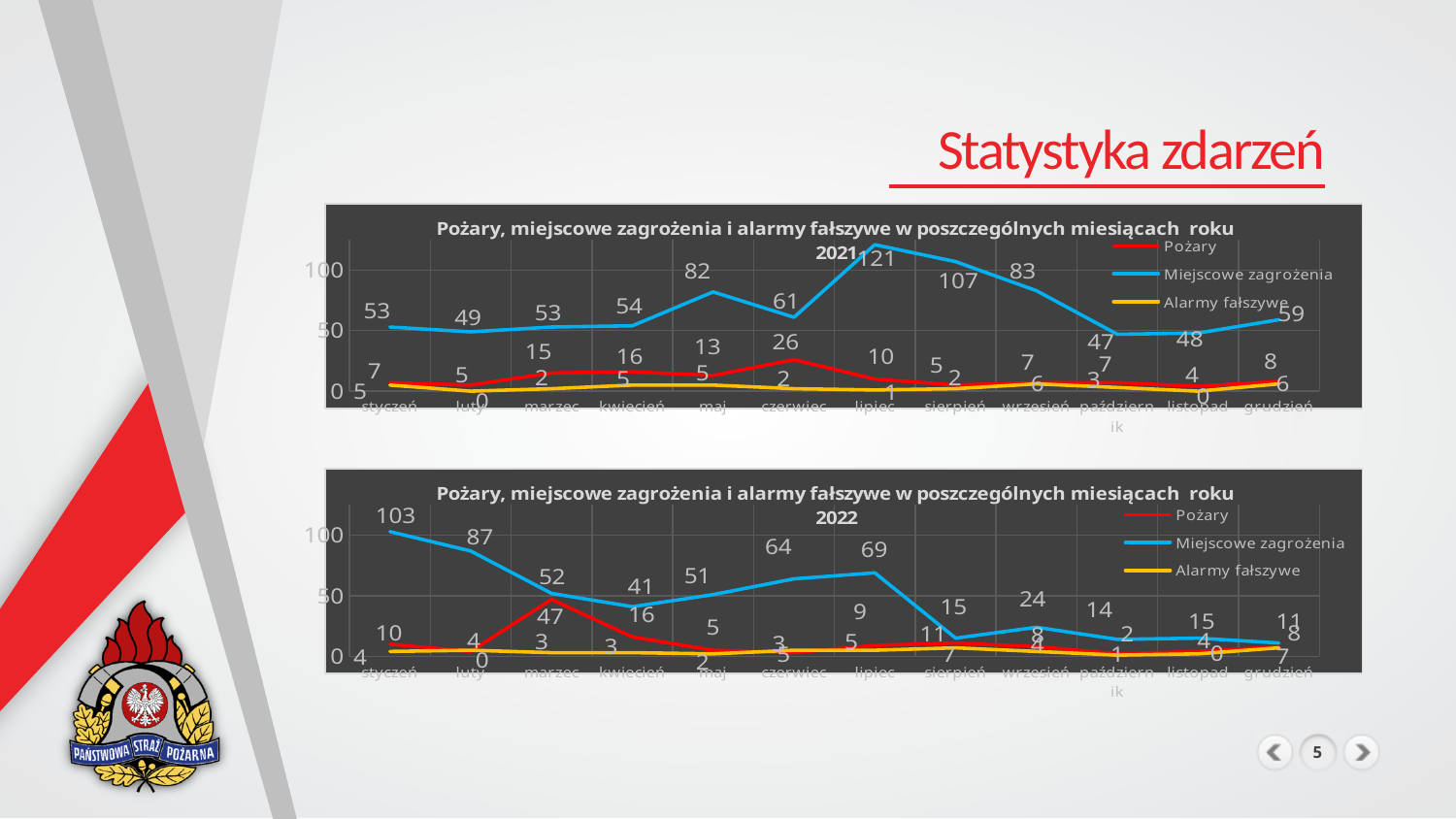
How many months are shown on the x axis of the 2021 chart (top)? 12 In the 2021 chart (top), in which month is Miejscowe zagrożenia highest? lipiec In the 2022 chart (bottom), in which month is Pożary highest? marzec In the 2021 chart (top), what is the value of Pożary in czerwiec? 26 In the 2022 chart (bottom), what is the value of Miejscowe zagrożenia in styczeń? 103 In the 2022 chart (bottom), what is the value of Pożary in marzec? 47 In the 2021 chart (top), what is the difference between Miejscowe zagrożenia in lipiec and in sierpień? 14 In the 2022 chart (bottom), which month has the larger value of Miejscowe zagrożenia, styczeń or luty? styczeń In the 2021 chart (top), what is the value of Miejscowe zagrożenia in lipiec? 121 What kind of chart is the 2022 chart (bottom)? line chart How many series does the legend of the 2021 chart (top) list? 3 In the 2022 chart (bottom), does Miejscowe zagrożenia rise or fall from styczeń to kwiecień? fall